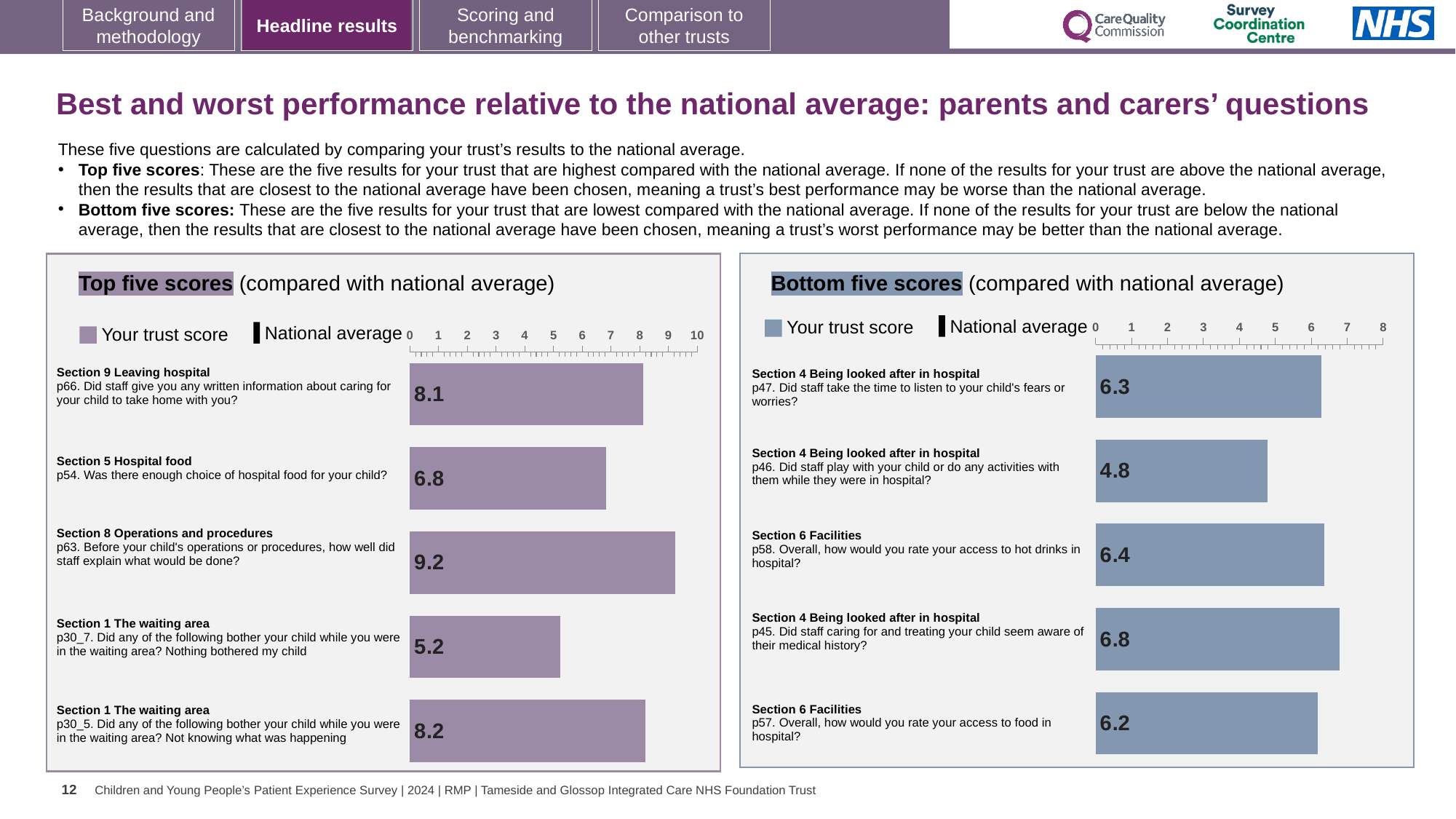
In the Bottom five scores chart, which question has the highest trust score? p45. Did staff caring for and treating your child seem aware of their medical history? In the Top five scores chart, which has the larger trust score: p54 (hospital food choice) or p30_7 (nothing bothered my child)? p54 What type of chart is the Top five scores chart? Bar chart How many questions are shown in the Bottom five scores chart? 5 In the Bottom five scores chart, what is the trust score for p46 (Did staff play with your child or do any activities with them while they were in hospital?)? 4.8 In the Top five scores chart, what is the difference between the trust scores for p63 and p30_7? 4.0 In the Top five scores chart, what is the trust score for p63 (Before your child's operations or procedures, how well did staff explain what would be done?)? 9.2 In the Top five scores chart, which question has the highest trust score? p63. Before your child's operations or procedures, how well did staff explain what would be done? In the Top five scores chart, which question has the lowest trust score? p30_7. Did any of the following bother your child while you were in the waiting area? Nothing bothered my child In the Bottom five scores chart, which question has the lowest trust score? p46. Did staff play with your child or do any activities with them while they were in hospital? In the Bottom five scores chart, what is the difference between the trust scores for p45 and p46? 2.0 How many series does the legend of the Bottom five scores chart list? 2